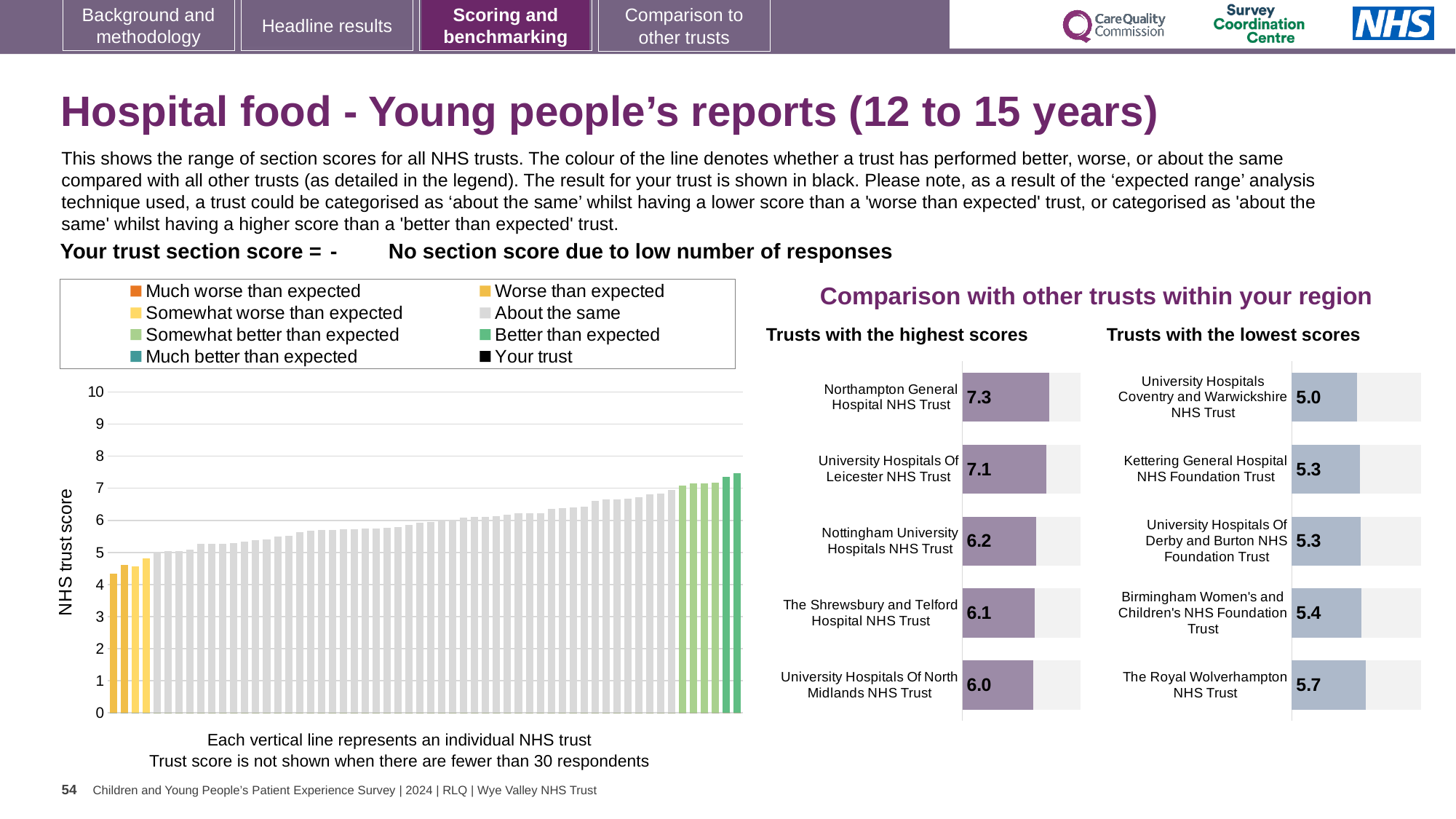
In the 'Trusts with the highest scores' chart, what is the difference between the scores of Northampton General Hospital NHS Trust and University Hospitals Of Leicester NHS Trust? 0.2 How many entries does the legend of the left-hand NHS trust score chart list? 8 In the 'Trusts with the highest scores' chart, what is the score for Northampton General Hospital NHS Trust? 7.3 In the 'Trusts with the lowest scores' chart, what is the score for The Royal Wolverhampton NHS Trust? 5.7 In the 'Trusts with the lowest scores' chart, which has the higher score: Birmingham Women's and Children's NHS Foundation Trust or The Royal Wolverhampton NHS Trust? The Royal Wolverhampton NHS Trust In the left-hand NHS trust score chart, is the value of the tallest bar greater or less than 7? greater In the 'Trusts with the highest scores' chart, which trust has the highest score? Northampton General Hospital NHS Trust In the 'Trusts with the lowest scores' chart, which trust has the lowest score? University Hospitals Coventry and Warwickshire NHS Trust In the left-hand NHS trust score chart, do the bar values rise or fall from left to right? Rise In the 'Trusts with the lowest scores' chart, what is the score for University Hospitals Coventry and Warwickshire NHS Trust? 5.0 What kind of chart is the left-hand chart showing NHS trust scores? Bar chart How many trusts are listed in the 'Trusts with the highest scores' chart? 5